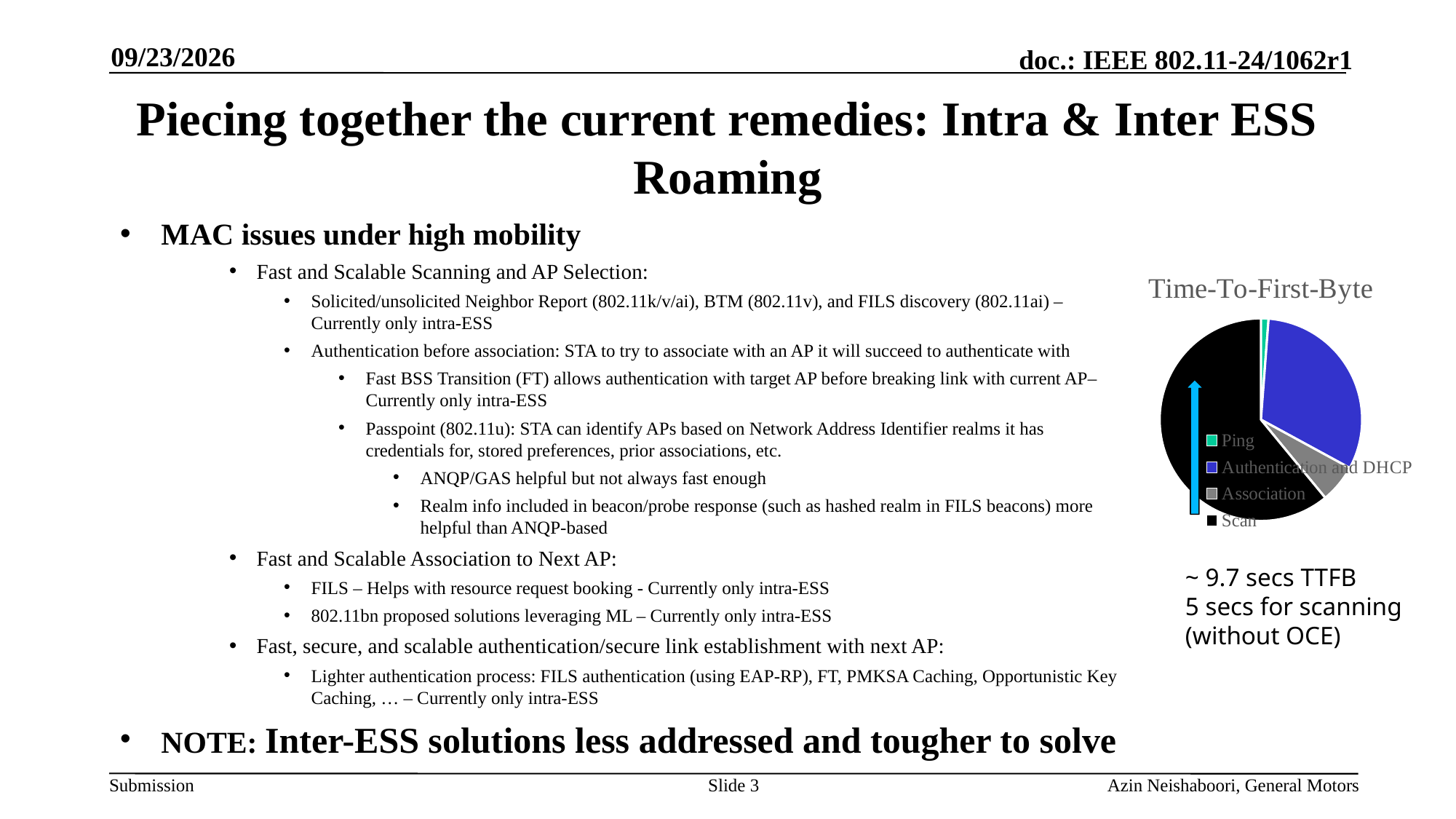
Which category takes the smallest share of the Time-To-First-Byte pie chart? Ping In the Time-To-First-Byte pie chart, which is larger: Authentication and DHCP or Association? Authentication and DHCP What colour is the Scan slice in the Time-To-First-Byte pie chart? black What kind of chart is shown on the slide? pie chart What is the title of the pie chart? Time-To-First-Byte How many categories does the Time-To-First-Byte pie chart have? 4 In the Time-To-First-Byte pie chart, which is larger: Association or Ping? Association Which category takes the largest share of the Time-To-First-Byte pie chart? Scan In the Time-To-First-Byte pie chart, which is larger: Scan or Authentication and DHCP? Scan How many entries does the legend of the Time-To-First-Byte chart list? 4